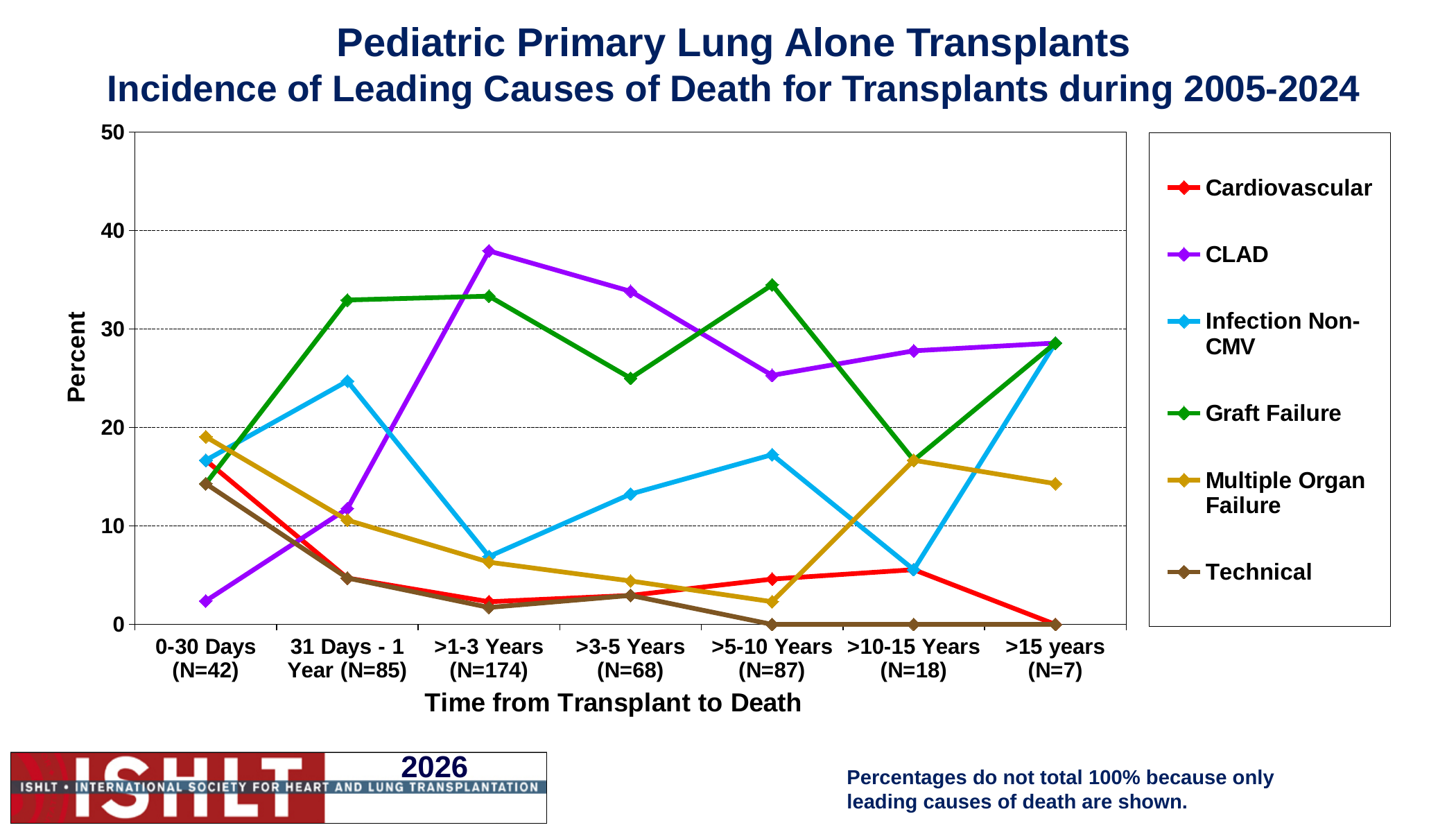
Is the value for Infection Non-CMV at >1-3 Years greater or less than 10? less Which cause of death has the highest value at >1-3 Years? CLAD Which cause of death has the lowest value at 0-30 Days? CLAD What kind of chart is shown on the slide? line chart Is the value for Multiple Organ Failure at >10-15 Years greater or less than 10? greater How many time-period categories are shown on the x axis? 7 Is the value for CLAD at >1-3 Years greater or less than 30? greater How many series does the legend list? 6 What is the title of the x axis? Time from Transplant to Death At >3-5 Years, which is larger: CLAD or Graft Failure? CLAD Which cause of death has the highest value at >5-10 Years? Graft Failure What is the value for Technical at >15 years? 0